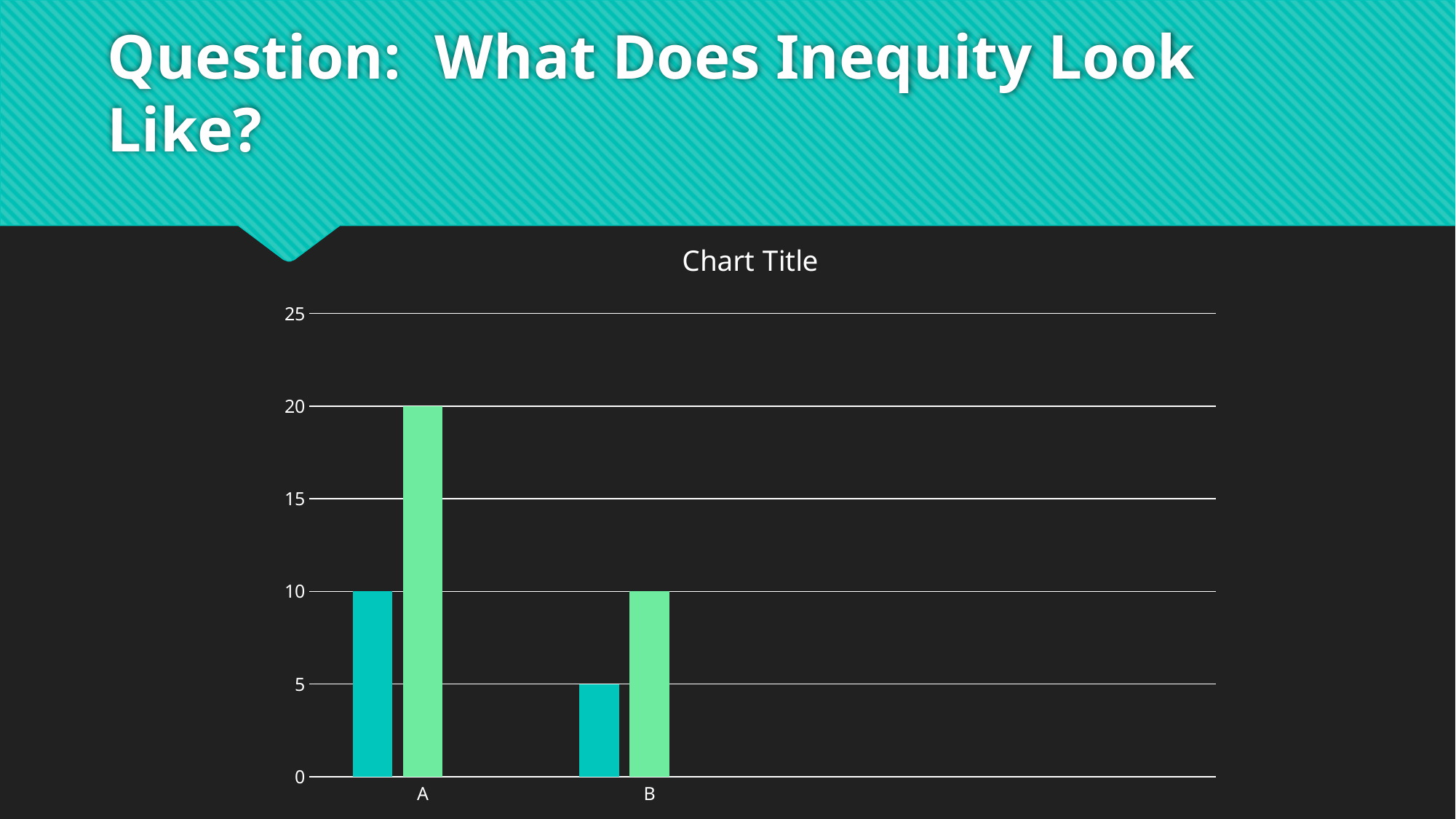
How many categories are shown on the x axis of the chart? 2 What type of chart is shown on the slide? bar chart Is the value of the light green bar for category A greater or less than 15? greater Which category has the tallest bar in the chart? A What is the value of the teal bar for category B? 5 Which is larger: the teal bar for A or the teal bar for B? the teal bar for A Which category has the shortest bar in the chart? B What is the title shown above the chart? Chart Title What is the value of the light green bar for category A? 20 What is the value of the teal bar for category A? 10 What is the value of the light green bar for category B? 10 What is the difference between the light green bar and the teal bar for category A? 10